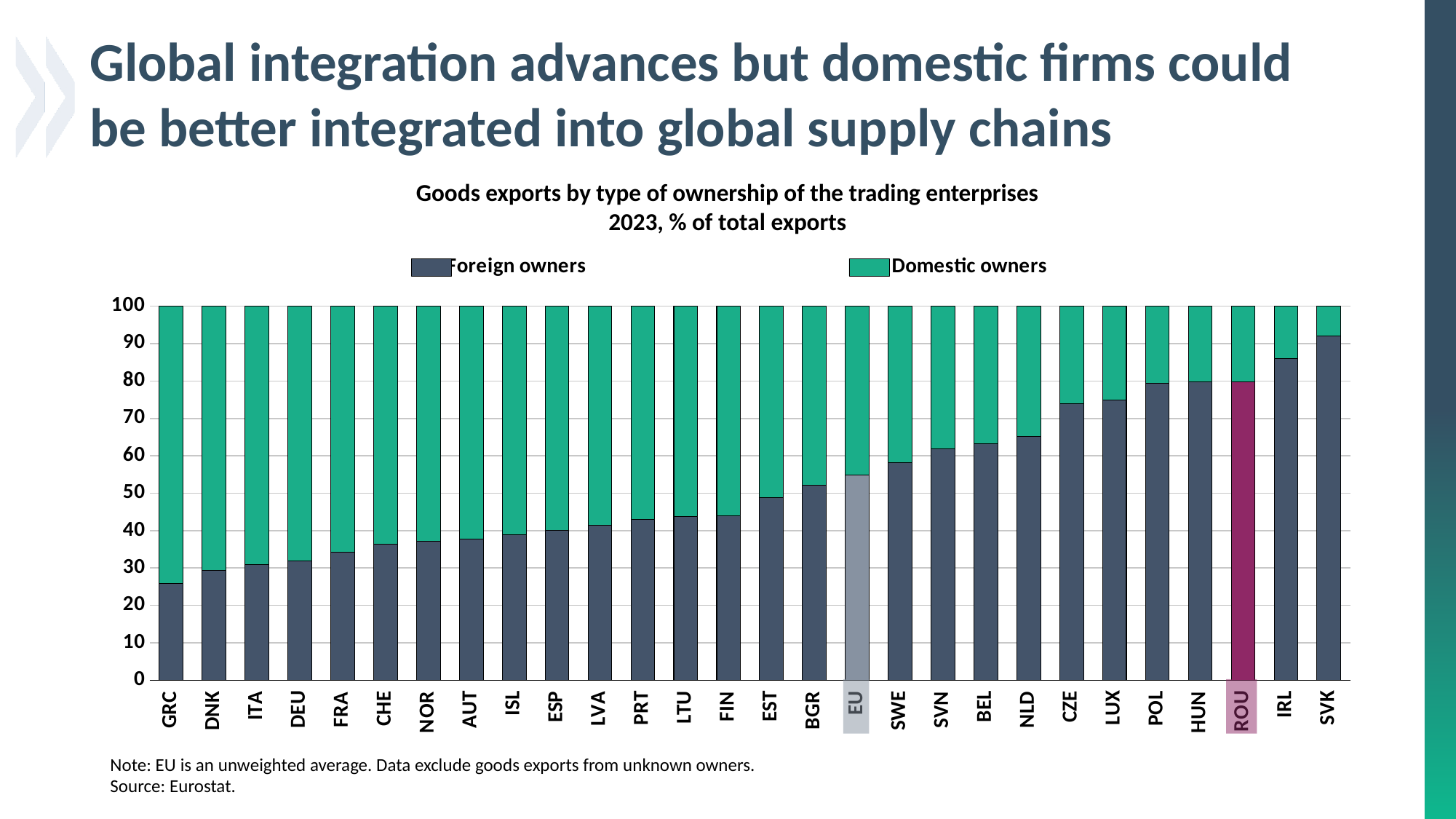
Which has a larger foreign owners share, ROU or EU? ROU Which category has the largest share of goods exports by domestic owners? GRC How many series does the legend list? 2 Is the foreign owners value for GRC greater or less than 30? less Do the foreign owners values rise or fall moving from left to right along the x axis? rise Which category has the lowest share of goods exports by foreign owners? GRC Which category has the highest share of goods exports by foreign owners? SVK How many countries/categories are shown on the x axis? 28 What kind of chart is shown on the slide? Stacked bar chart What is the total of the stacked bar for ROU? 100 Is the foreign owners value for SVK greater or less than 90? greater Is the foreign owners value for ROU greater or less than 70? greater